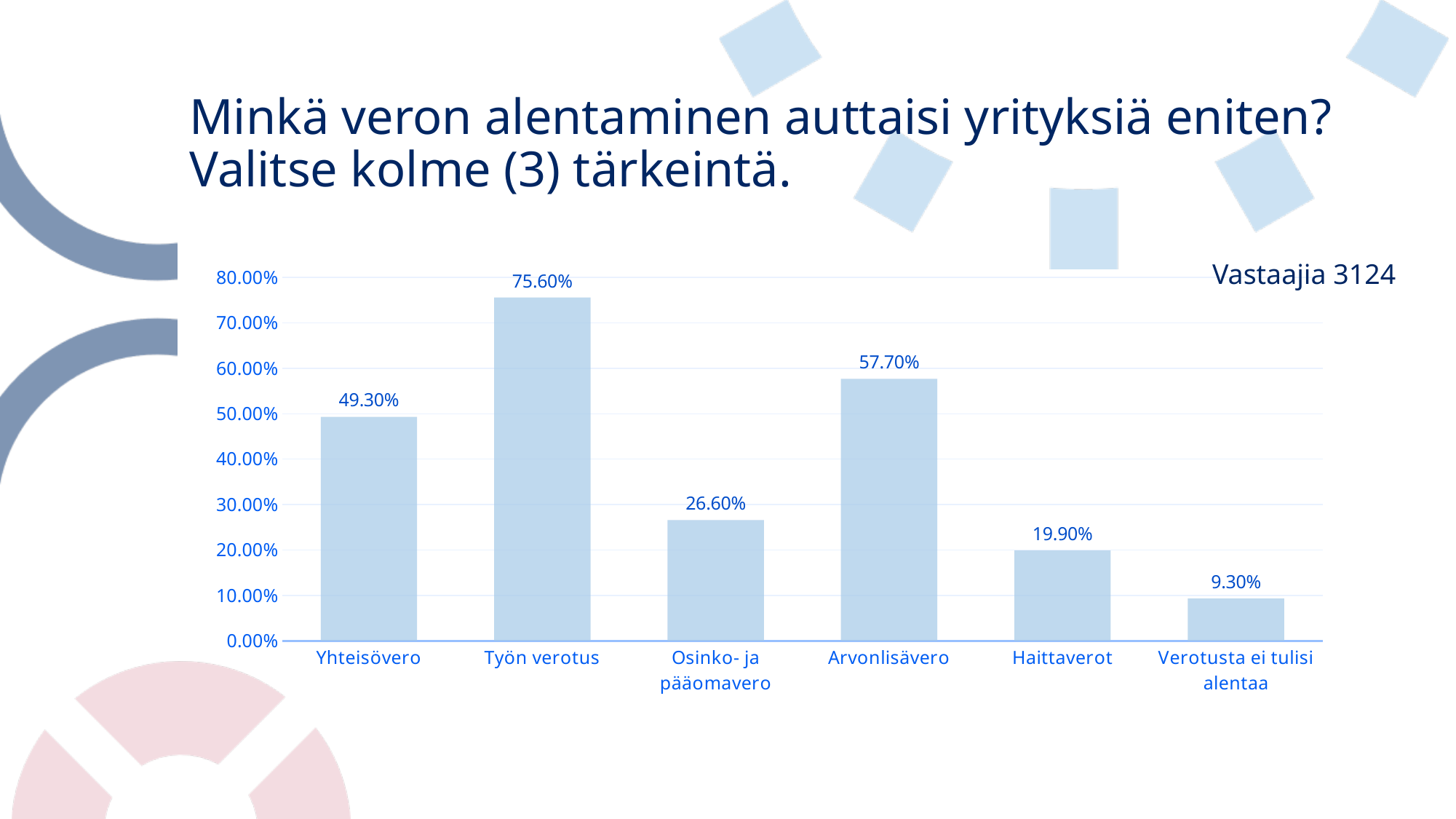
What is the value for Haittaverot? 19.90% Is the value for Yhteisövero greater or less than 40.00%? greater How many categories are shown on the x axis? 6 What is the value for Verotusta ei tulisi alentaa? 9.30% How many respondents (Vastaajia) does the slide report? 3124 Which category has the lowest value? Verotusta ei tulisi alentaa Which is larger, the value for Osinko- ja pääomavero or the value for Haittaverot? Osinko- ja pääomavero What is the value for Arvonlisävero? 57.70% What is the value for Työn verotus? 75.60% What kind of chart is shown on the slide? bar chart What is the difference between the values for Työn verotus and Yhteisövero? 26.30% Which category has the highest value? Työn verotus